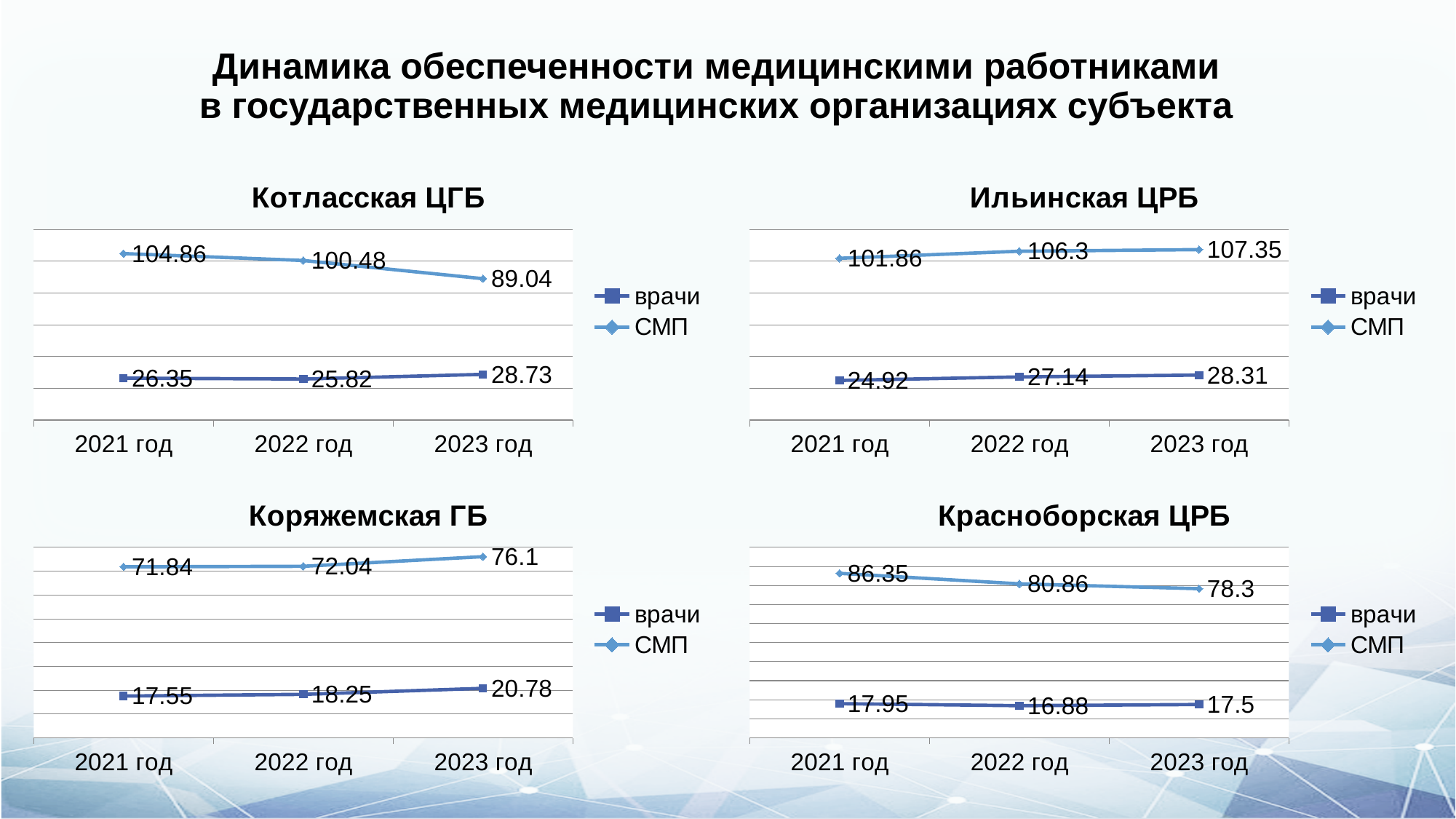
In the Ильинская ЦРБ chart, what is the value for врачи in 2021 год? 24.92 In the Красноборская ЦРБ chart, what is the value for врачи in 2022 год? 16.88 In the Ильинская ЦРБ chart, in which year is the СМП value highest? 2023 год In the Котласская ЦГБ chart, what is the value for СМП in 2023 год? 89.04 What kind of chart is the Котласская ЦГБ chart? line chart In the Красноборская ЦРБ chart, in which year is the врачи value lowest? 2022 год In the Котласская ЦГБ chart, what is the difference between the СМП values for 2021 год and 2023 год? 15.82 In the Красноборская ЦРБ chart, does the СМП series rise or fall from 2021 год to 2023 год? fall In the Коряжемская ГБ chart, which is larger: the врачи value in 2021 год or in 2023 год? 2023 год How many series does the legend of the Ильинская ЦРБ chart list? 2 How many years are shown on the x axis of the Коряжемская ГБ chart? 3 In the Коряжемская ГБ chart, what is the value for СМП in 2022 год? 72.04